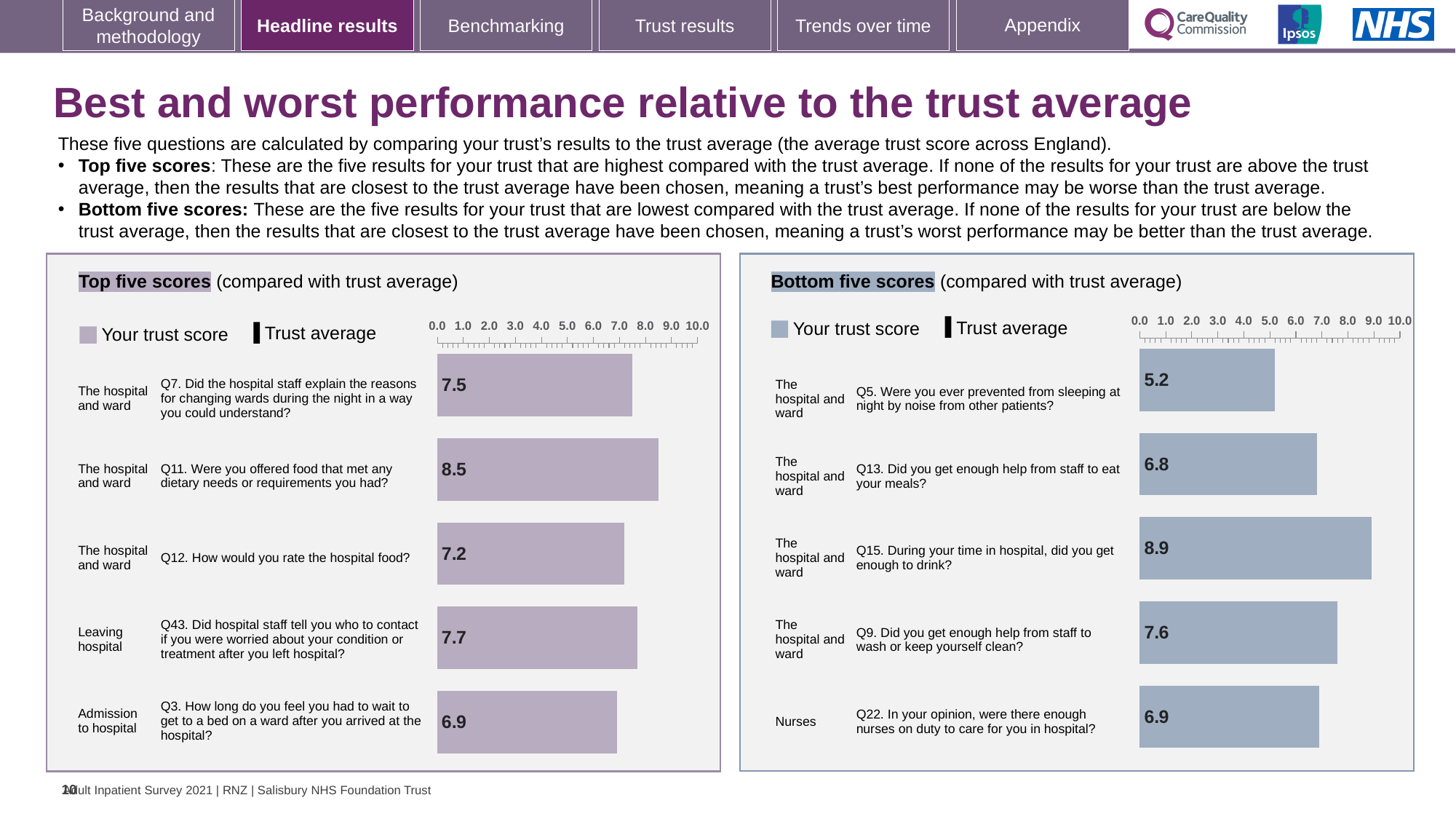
In the Top five scores chart, which question has the highest trust score? Q11 (8.5) What type of chart is used in the Top five scores panel? Bar chart In the Top five scores chart, which question has the lowest trust score? Q3 (6.9) In the Top five scores chart, what is the difference between the scores for Q11 and Q3? 1.6 In the Bottom five scores chart, what is the trust score for Q5 (Were you ever prevented from sleeping at night by noise from other patients?)? 5.2 In the Top five scores chart, what is the trust score for Q11 (Were you offered food that met any dietary needs or requirements you had?)? 8.5 How many questions are shown in the Bottom five scores chart? 5 In the Bottom five scores chart, which question has the lowest trust score? Q5 (5.2) In the Bottom five scores chart, what is the difference between the scores for Q15 and Q5? 3.7 In the Bottom five scores chart, which question has the highest trust score? Q15 (8.9) In the Top five scores chart, which has the higher score: Q7 or Q43? Q43 In the Bottom five scores chart, what is the trust score for Q22 about whether there were enough nurses on duty? 6.9